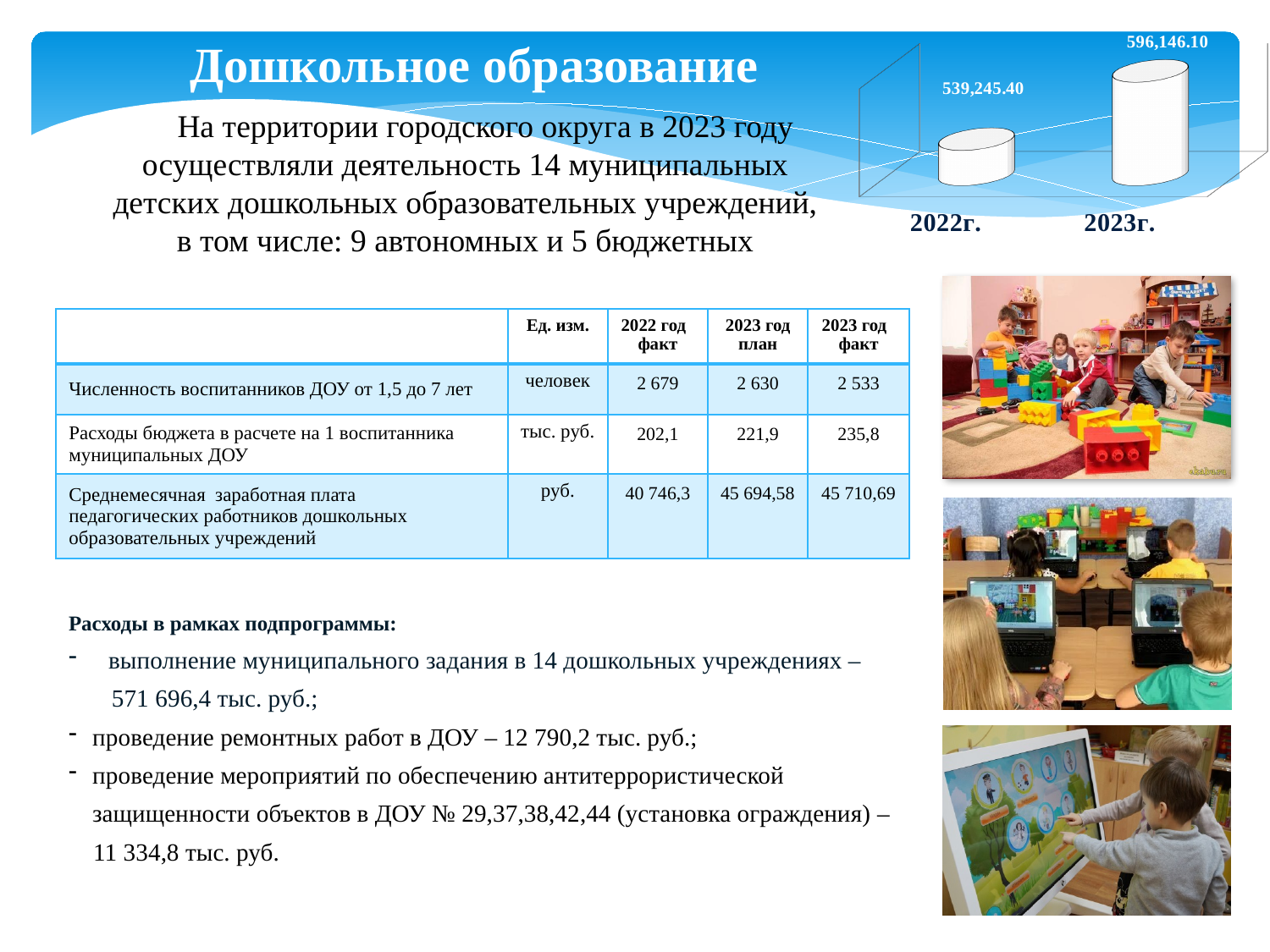
What are the category labels on the x axis of the chart at the top right of the slide? 2022г. and 2023г. How many categories (years) are plotted in the chart at the top right of the slide? 2 What kind of chart is shown at the top right of the slide? bar chart In the chart at the top right, which year has the lower value? 2022г. What is the value shown for 2022г. in the chart at the top right of the slide? 539,245.40 What is the value shown for 2023г. in the chart at the top right of the slide? 596,146.10 In the chart at the top right, is the value for 2023г. larger or smaller than the value for 2022г.? larger In the chart at the top right, which year has the higher value? 2023г. In the chart at the top right, by how much does the 2023г. value exceed the 2022г. value? 56,900.70 In the chart at the top right, do the values rise or fall from 2022г. to 2023г.? rise